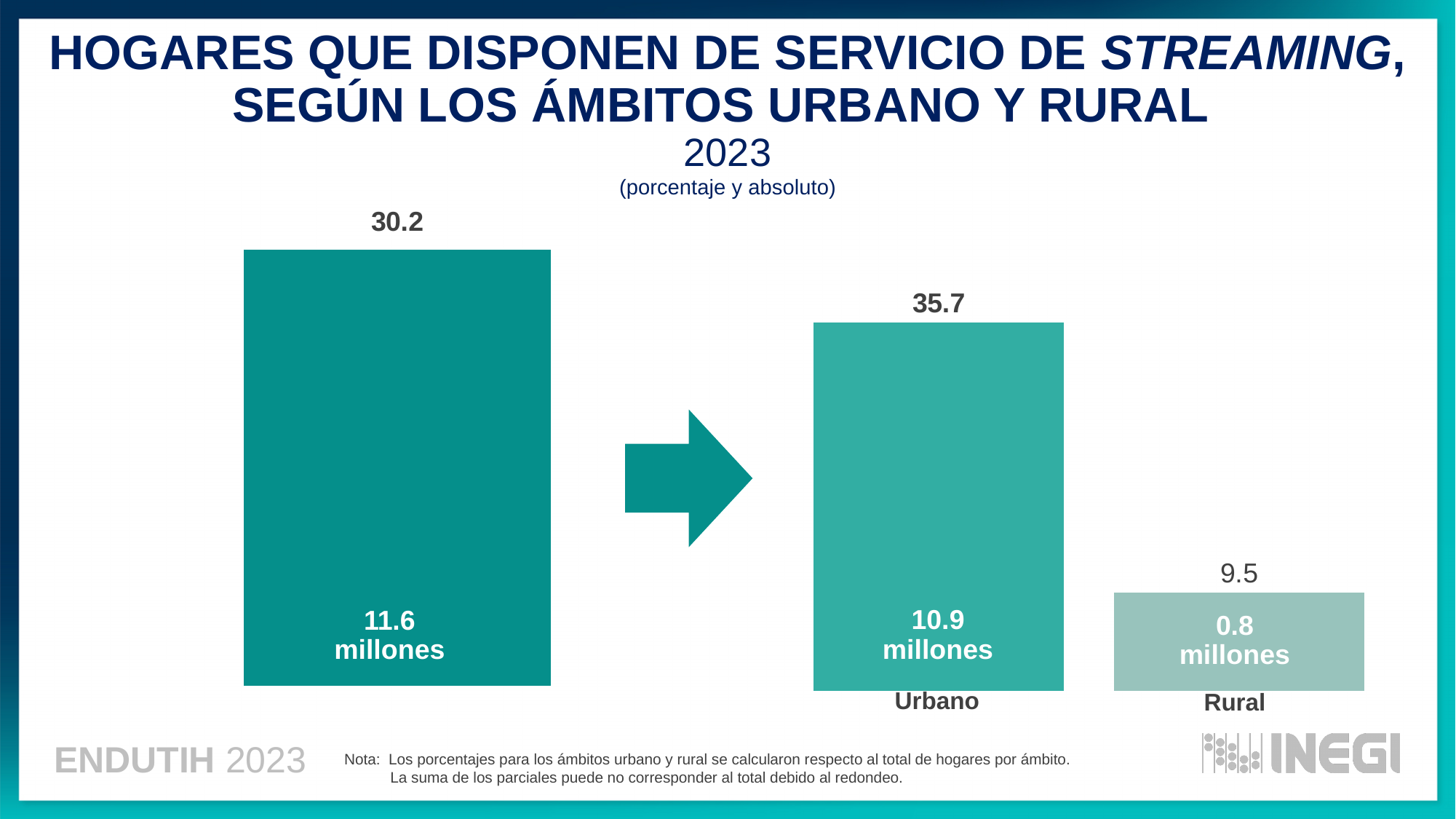
What absolute number of households is shown inside the Rural bar? 0.8 millones What absolute number of households is shown inside the Urbano bar? 10.9 millones What year does the chart title refer to? 2023 Which has the higher percentage, Urbano or Rural? Urbano How many bars are shown on the chart? 3 What is the difference in millions of households between Urbano and Rural? 10.1 millones What kind of chart is shown on the slide? Bar chart What percentage is printed above the leftmost bar? 30.2 What absolute number is printed inside the leftmost bar? 11.6 millones What is the difference in percentage points between Urbano and Rural? 26.2 What percentage is shown for Urbano? 35.7 What percentage is shown for Rural? 9.5